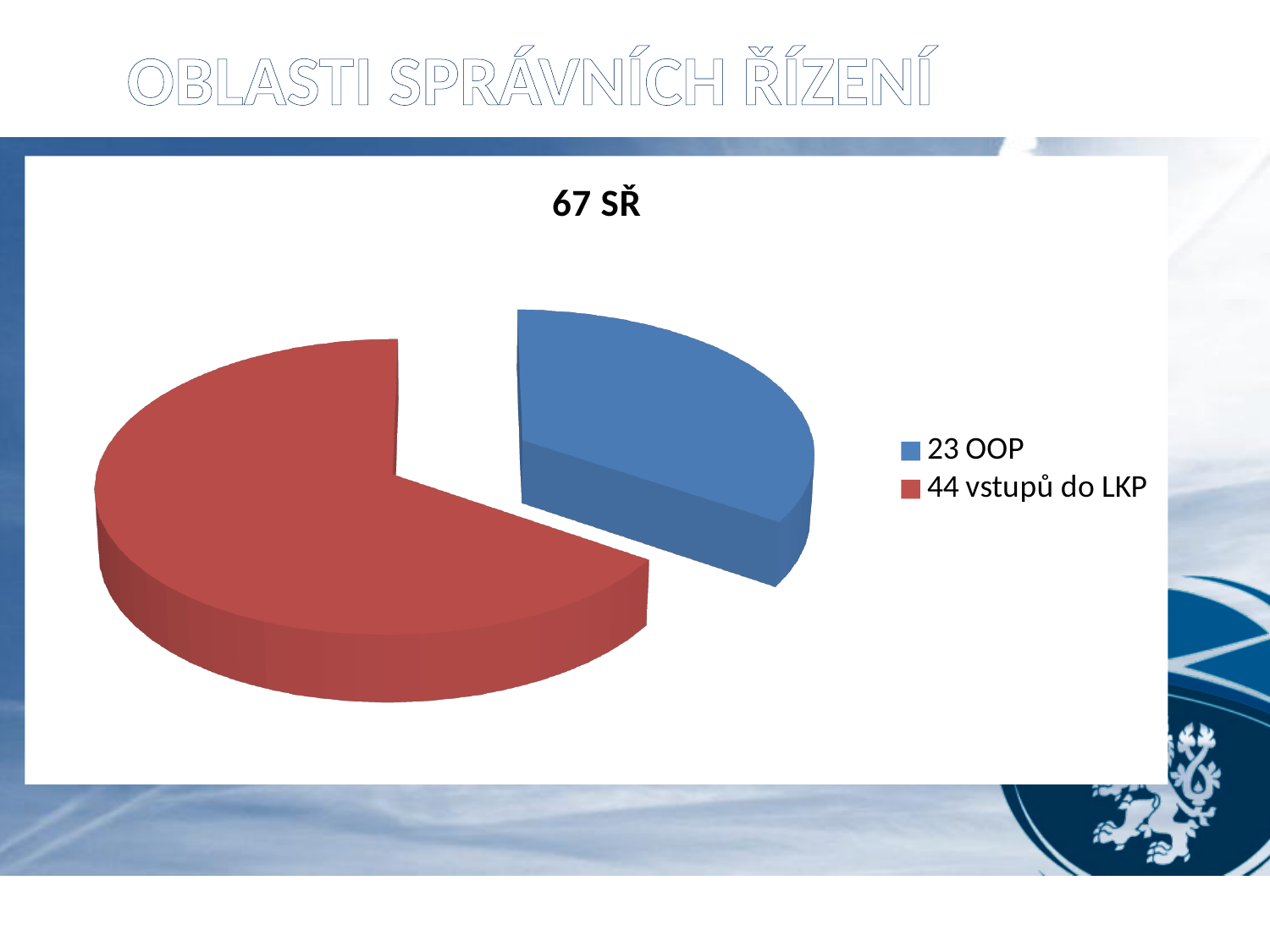
Which category has the larger slice of the pie? 44 vstupů do LKP What is the total of the two slices in the pie chart? 67 What is the title of the chart? 67 SŘ How many OOP are shown in the chart? 23 What is the difference between the number of vstupů do LKP and the number of OOP? 21 How many entries does the legend list? 2 How many 'vstupů do LKP' are shown in the chart? 44 Is the value for OOP larger or smaller than the value for vstupů do LKP? smaller Which category has the smaller slice of the pie? 23 OOP How many slices does the pie chart have? 2 Which colour represents the OOP slice? blue What kind of chart is shown on the slide? pie chart